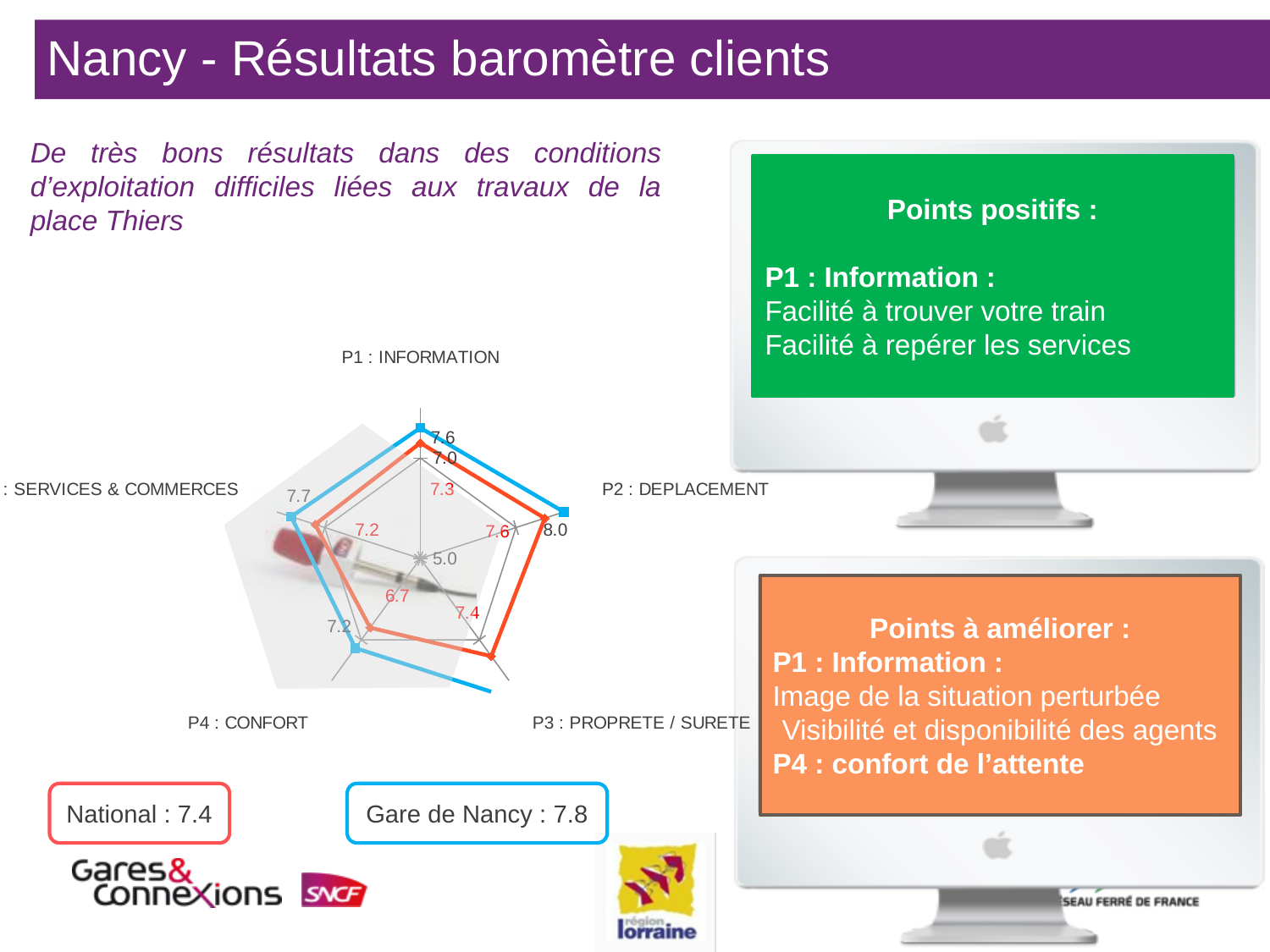
What is the National value for P3 : PROPRETE / SURETE? 7.4 What is the Gare de Nancy value for SERVICES & COMMERCES? 7.7 What is the National value for P4 : CONFORT? 6.7 What is the difference between the Gare de Nancy and National values for P2 : DEPLACEMENT? 0.4 How many axes (categories) does the radar chart have? 5 What is the Gare de Nancy value for P1 : INFORMATION? 7.6 On which axis does the National series have its lowest value? P4 : CONFORT What is the Gare de Nancy value for P2 : DEPLACEMENT? 8.0 What kind of chart is shown on the slide? radar chart On which axis does the National series have its highest value? P2 : DEPLACEMENT What is the National value for P1 : INFORMATION? 7.3 What overall score is shown for Gare de Nancy in the legend box? 7.8